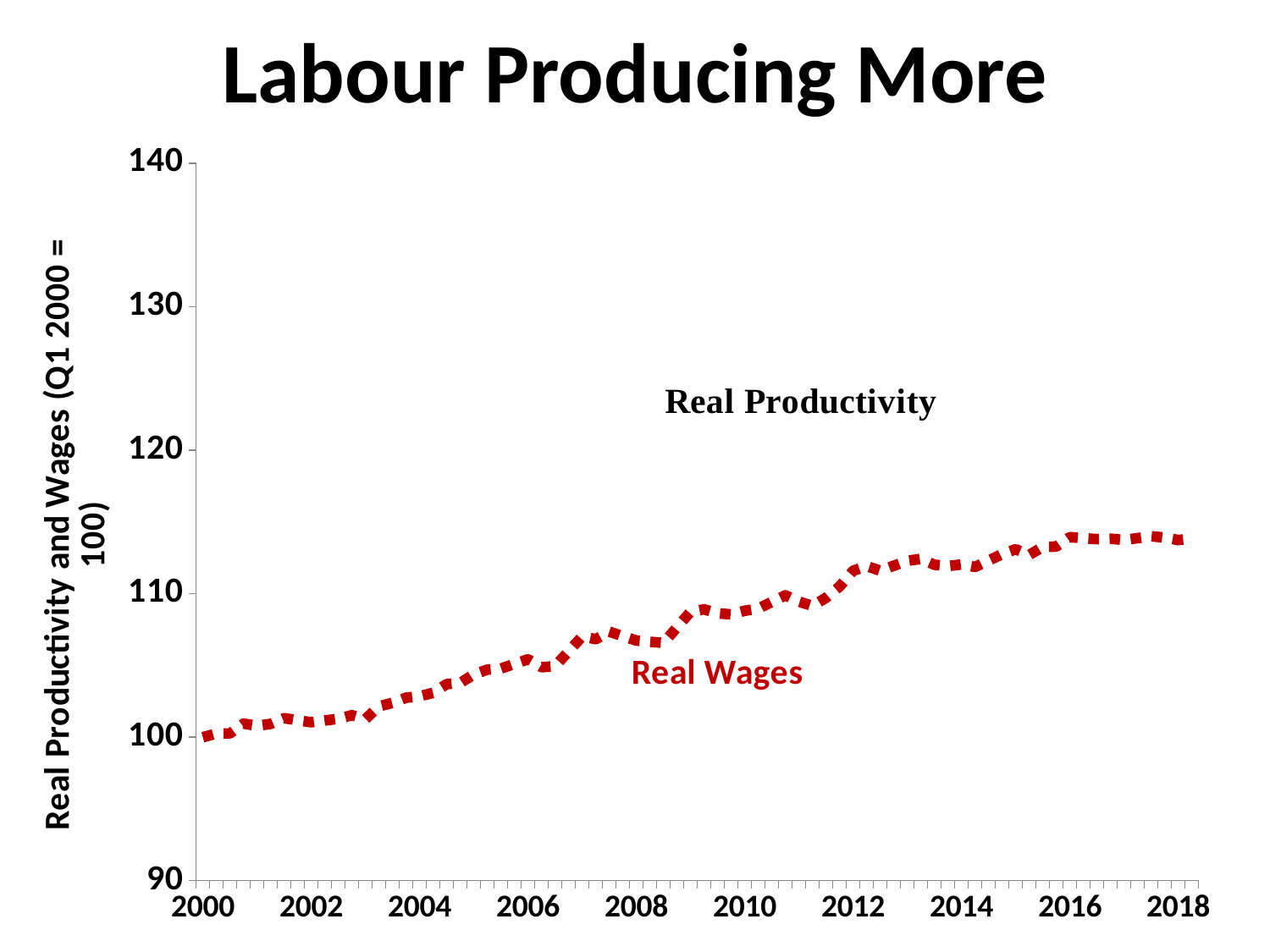
What is the label of the red dotted line? Real Wages Is the value for Real Wages in 2018 greater or less than 110? greater What is the value of Real Wages in 2000? 100 Is the value for Real Wages in 2016 greater or less than 120? less What is the title of the chart? Labour Producing More In which year is the Real Wages value lowest? 2000 What kind of chart is shown on the slide? line chart Which is larger, the Real Wages value in 2012 or in 2006? 2012 Is the value for Real Wages in 2008 greater or less than 110? less Do Real Wages generally rise or fall from 2000 to 2018? rise Which is larger, the Real Wages value in 2018 or in 2000? 2018